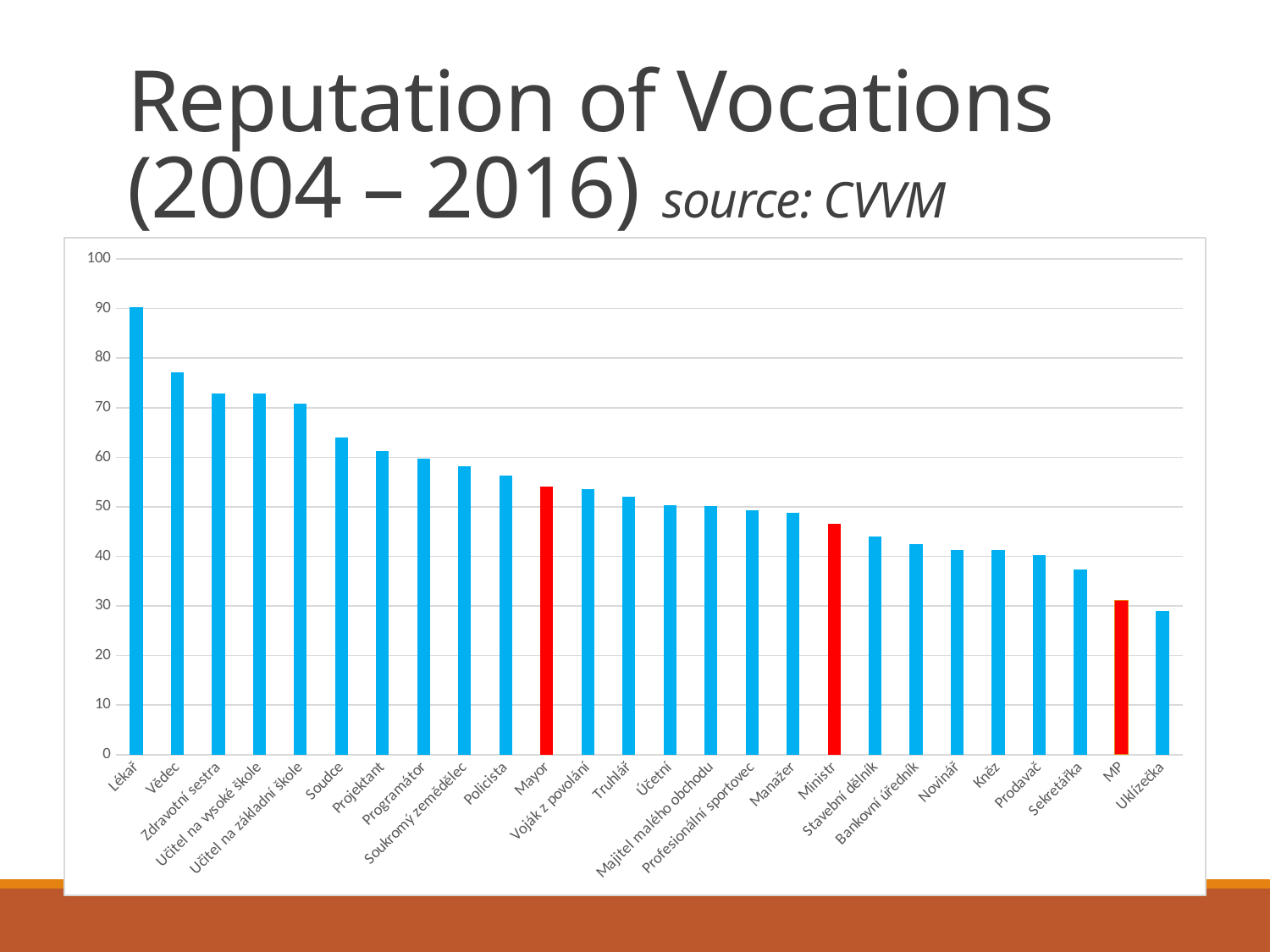
Which vocation has the lowest reputation value in the chart? Uklízečka Which has the larger value, Mayor or Ministr? Mayor Which vocation has the highest reputation value in the chart? Lékař How many vocations are plotted in the chart? 26 Is the value for Ministr greater or less than 50? less Which has the larger value, Vědec or Zdravotní sestra? Vědec What kind of chart is shown on the slide? bar chart Is the value for Soudce greater or less than 60? greater Is the value for Lékař greater or less than 80? greater Which three vocations are shown with red bars? Mayor, Ministr, MP Do the values rise or fall moving from left to right along the x axis? fall